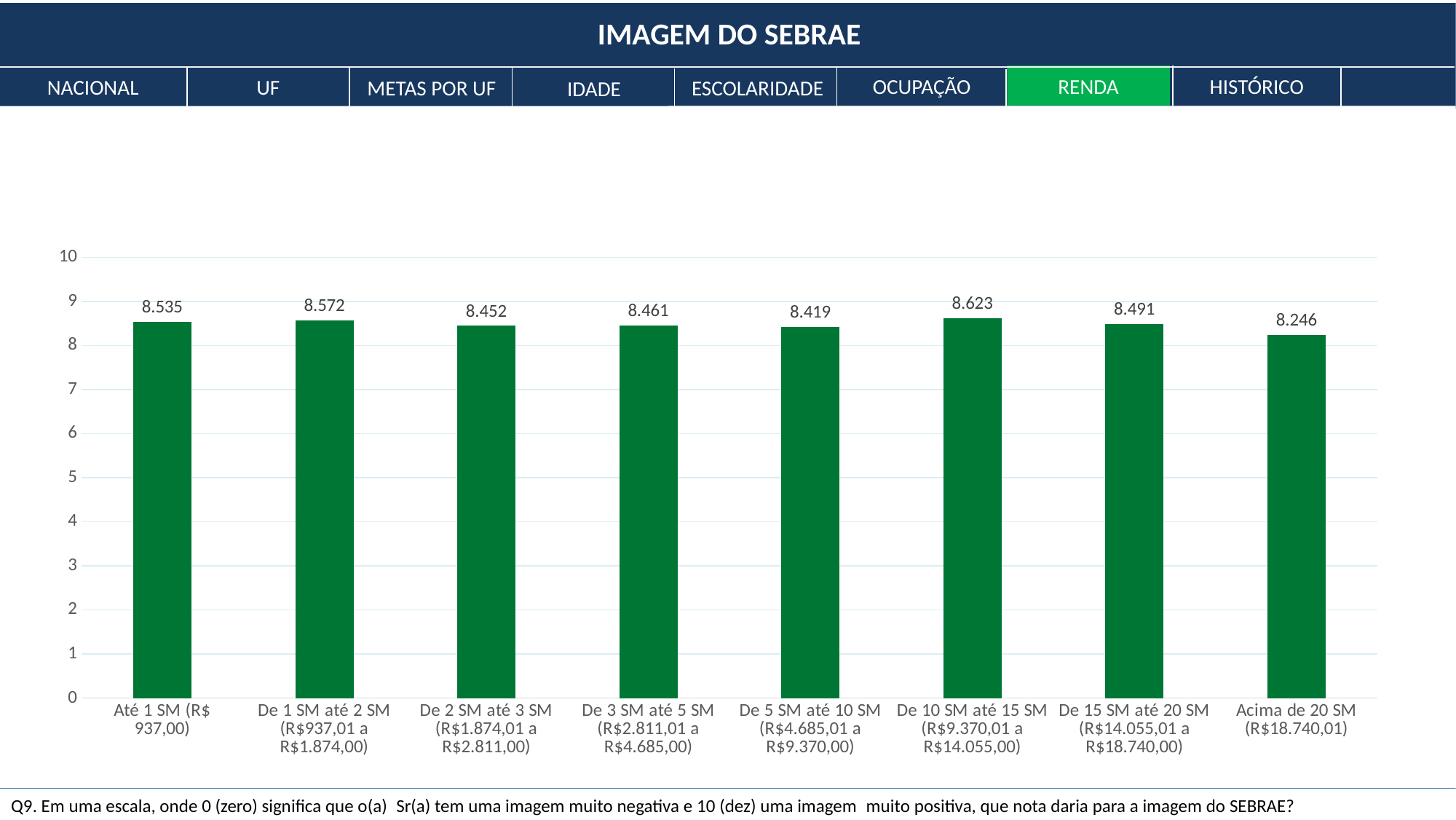
Which income group has the highest value? De 10 SM até 15 SM What is the value for the 'Até 1 SM (R$ 937,00)' income group? 8.535 Which income group has the lowest value? Acima de 20 SM Is the value for 'De 15 SM até 20 SM' greater or less than 8? greater What kind of chart is shown on the slide? Bar chart Which tab is highlighted in green in the navigation bar at the top of the slide? RENDA Which has a larger value: 'De 1 SM até 2 SM' or 'De 2 SM até 3 SM'? De 1 SM até 2 SM How many income groups are shown on the chart? 8 What is the value for the 'Acima de 20 SM (R$18.740,01)' income group? 8.246 What is the value for the 'De 10 SM até 15 SM' income group? 8.623 What is the value for the 'De 5 SM até 10 SM' income group? 8.419 What is the difference between the values for 'De 10 SM até 15 SM' and 'Acima de 20 SM'? 0.377